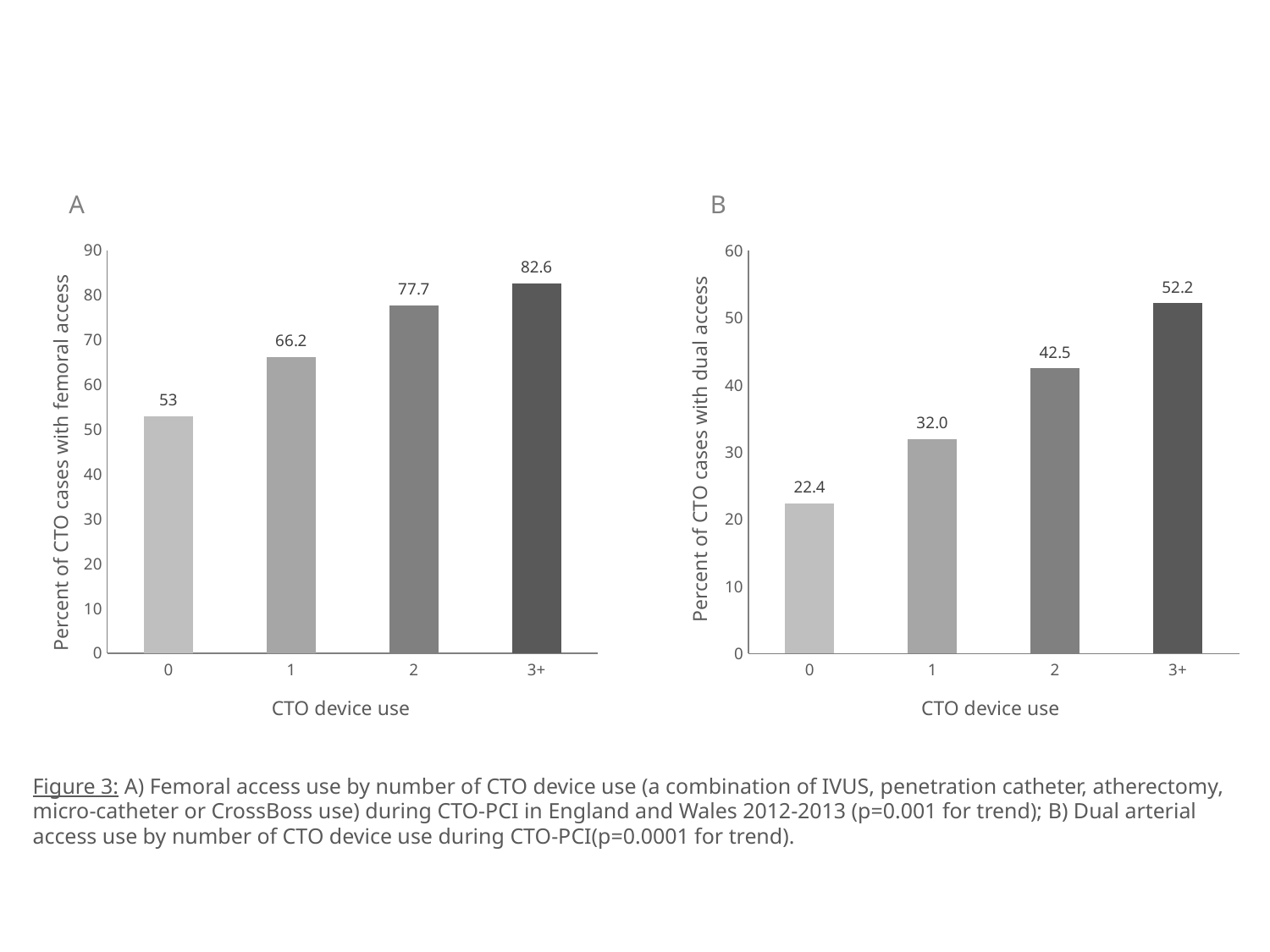
In chart B (dual access), what is the value for CTO device use of 2? 42.5 What kind of chart is chart A (femoral access)? Bar chart In chart B (dual access), which CTO device use category has the lowest value? 0 In chart B (dual access), do the values rise or fall as CTO device use increases from 0 to 3+? Rise In chart B (dual access), what is the difference between the values for 1 and 0 devices? 9.6 How many CTO device use categories are shown in chart B (dual access)? 4 In chart A (femoral access), what is the difference between the values for 3+ and 0 devices? 29.6 In chart B (dual access), which is larger: the value for 2 devices or the value for 1 device? 2 devices In chart A (femoral access), what is the value for CTO device use of 1? 66.2 What is the y-axis label of chart A? Percent of CTO cases with femoral access In chart A (femoral access), which CTO device use category has the highest value? 3+ In chart A (femoral access), is the value for 2 devices greater or less than 70? greater